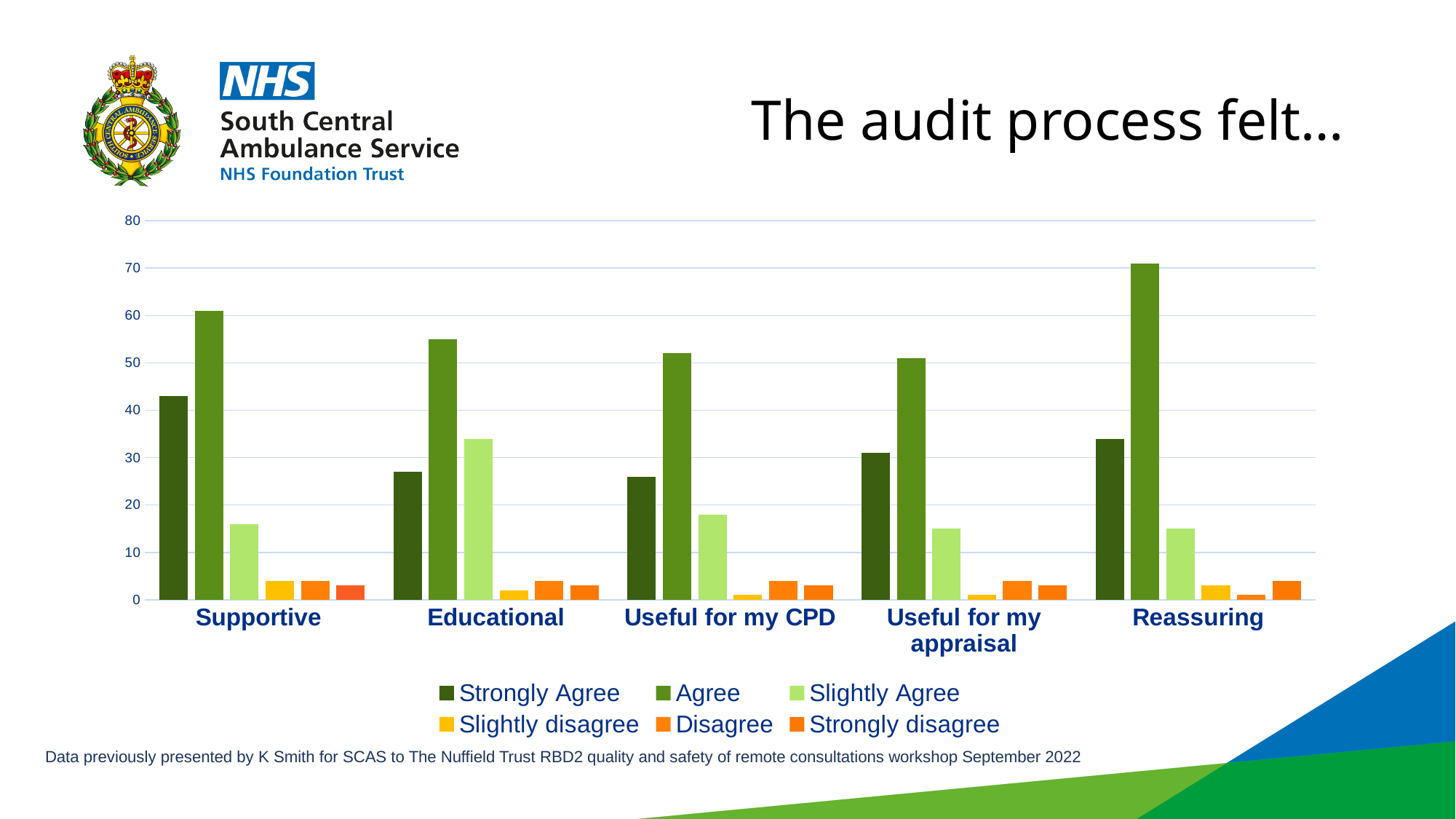
How many categories are shown along the x axis of the chart? 5 How many series does the chart's legend list? 6 Which is larger, the Slightly Agree value for Supportive or the Slightly Agree value for Educational? Educational Which is larger, the Agree value for Supportive or the Agree value for Educational? Supportive Is the Strongly Agree value for Supportive greater or less than 40? greater Which category has the highest Slightly Agree value? Educational Which category has the highest Agree value? Reassuring What kind of chart is shown on the slide? bar chart Is the Agree value for Reassuring greater or less than 60? greater Which category has the highest Strongly Agree value? Supportive Is the Strongly Agree value for Useful for my CPD greater or less than 30? less What is the title shown above the chart on the slide? The audit process felt…